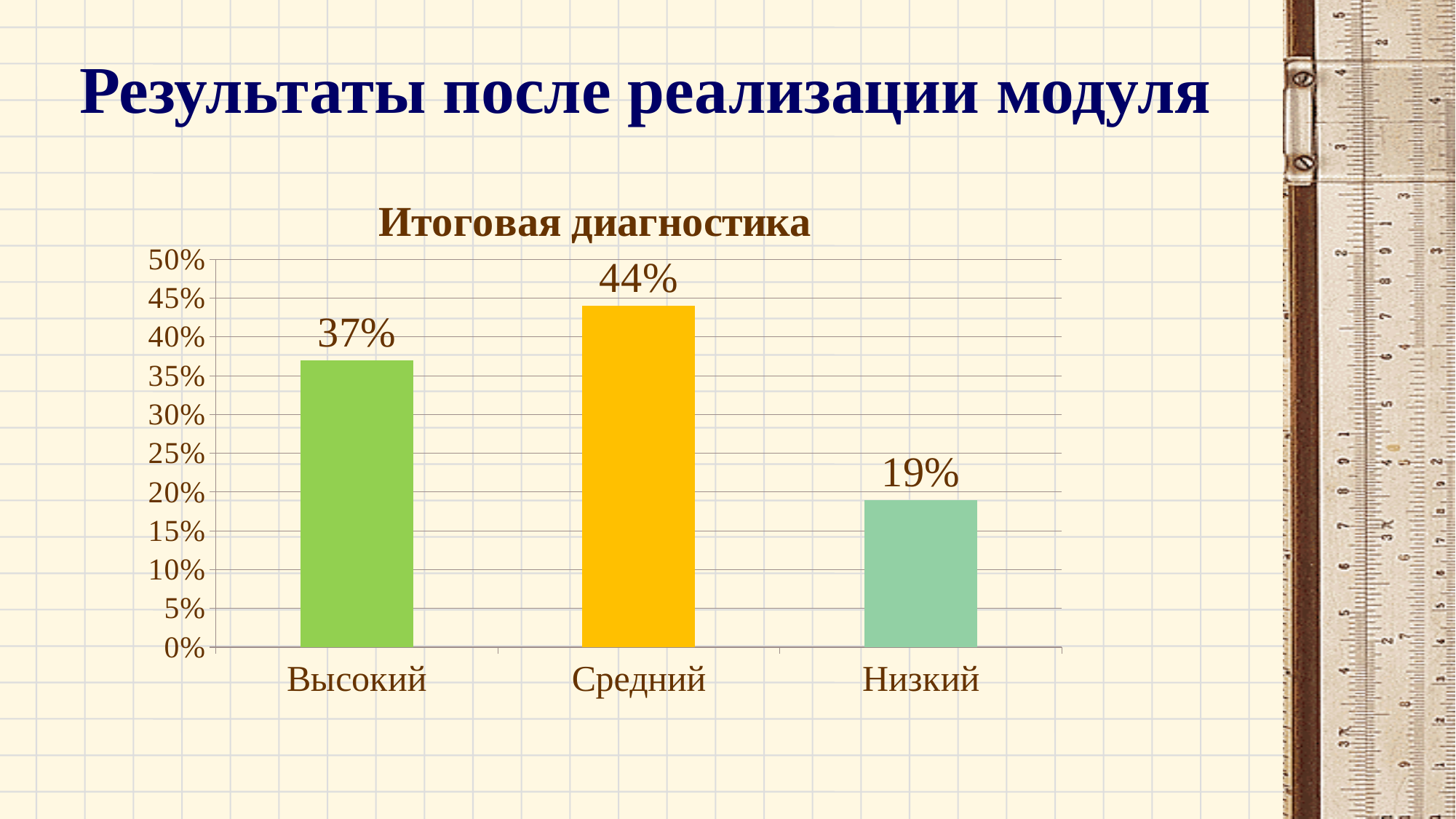
What is the difference between the values for Высокий and Низкий? 18% Which category has the lowest value? Низкий Which category has the highest value? Средний What kind of chart is shown on the slide? bar chart How many categories are shown on the x axis? 3 What is the value for Средний? 44% What is the title of the chart? Итоговая диагностика Which is larger, the value for Высокий or the value for Низкий? Высокий Is the value for Средний greater or less than 40%? greater What is the value for Высокий? 37% What is the value for Низкий? 19% What is the difference between the values for Средний and Высокий? 7%